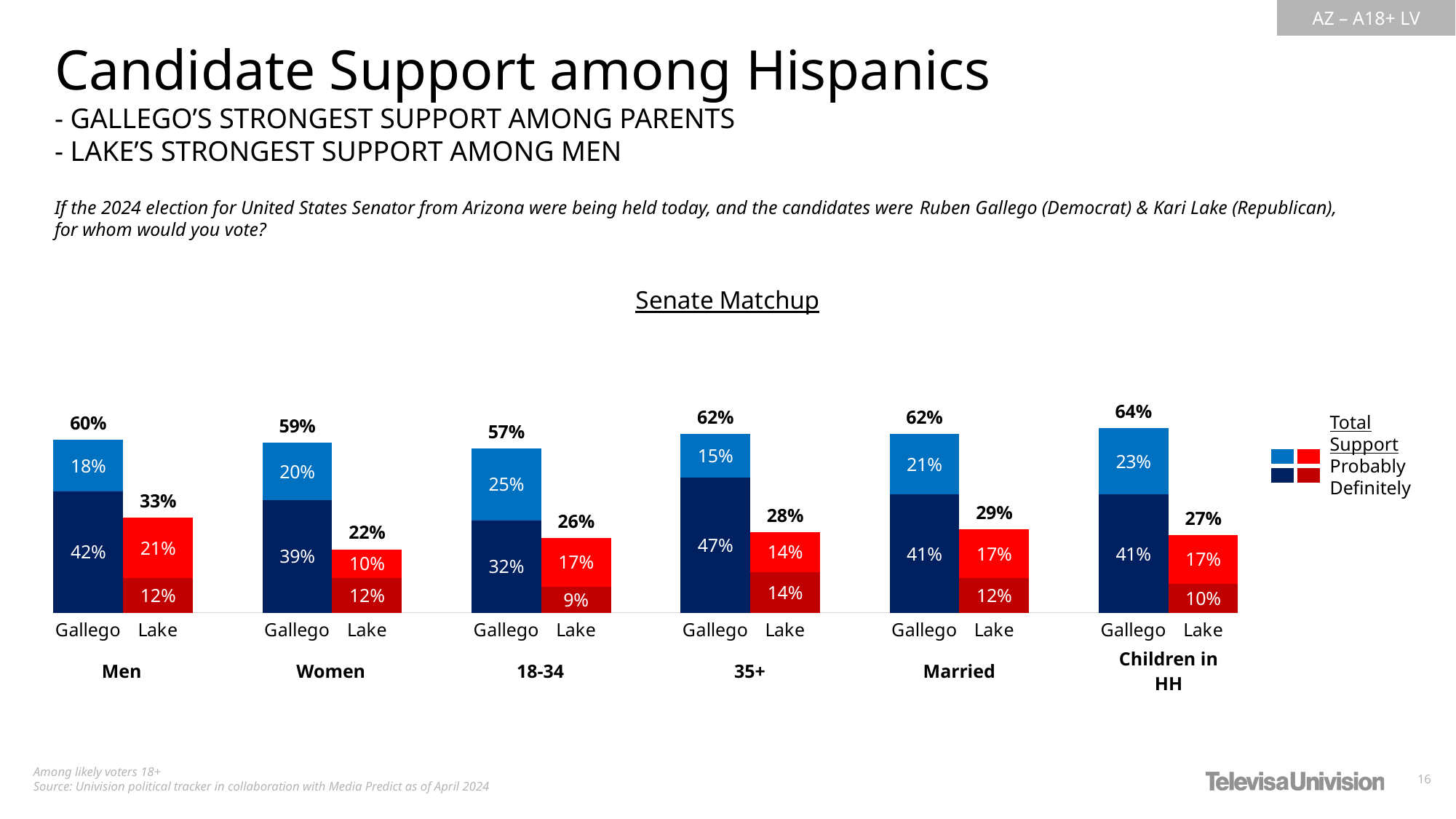
What is Lake's total support among voters aged 35+? 28% In which demographic group is Lake's total support lowest? Women What two levels of support does the legend distinguish? Probably and Definitely What share of 18-34 year olds say they would probably vote for Gallego? 25% What share of Women say they would definitely vote for Lake? 12% Among Men, how many percentage points higher is Gallego's total support than Lake's? 27 percentage points How many demographic groups are shown in the Senate Matchup chart? 6 What kind of chart is the Senate Matchup chart? Stacked bar chart What is Gallego's total support among Men? 60% Is Lake's total support higher among Men or among Married voters? Men In which demographic group is Gallego's total support highest? Children in HH What share of voters aged 35+ say they would definitely vote for Gallego? 47%